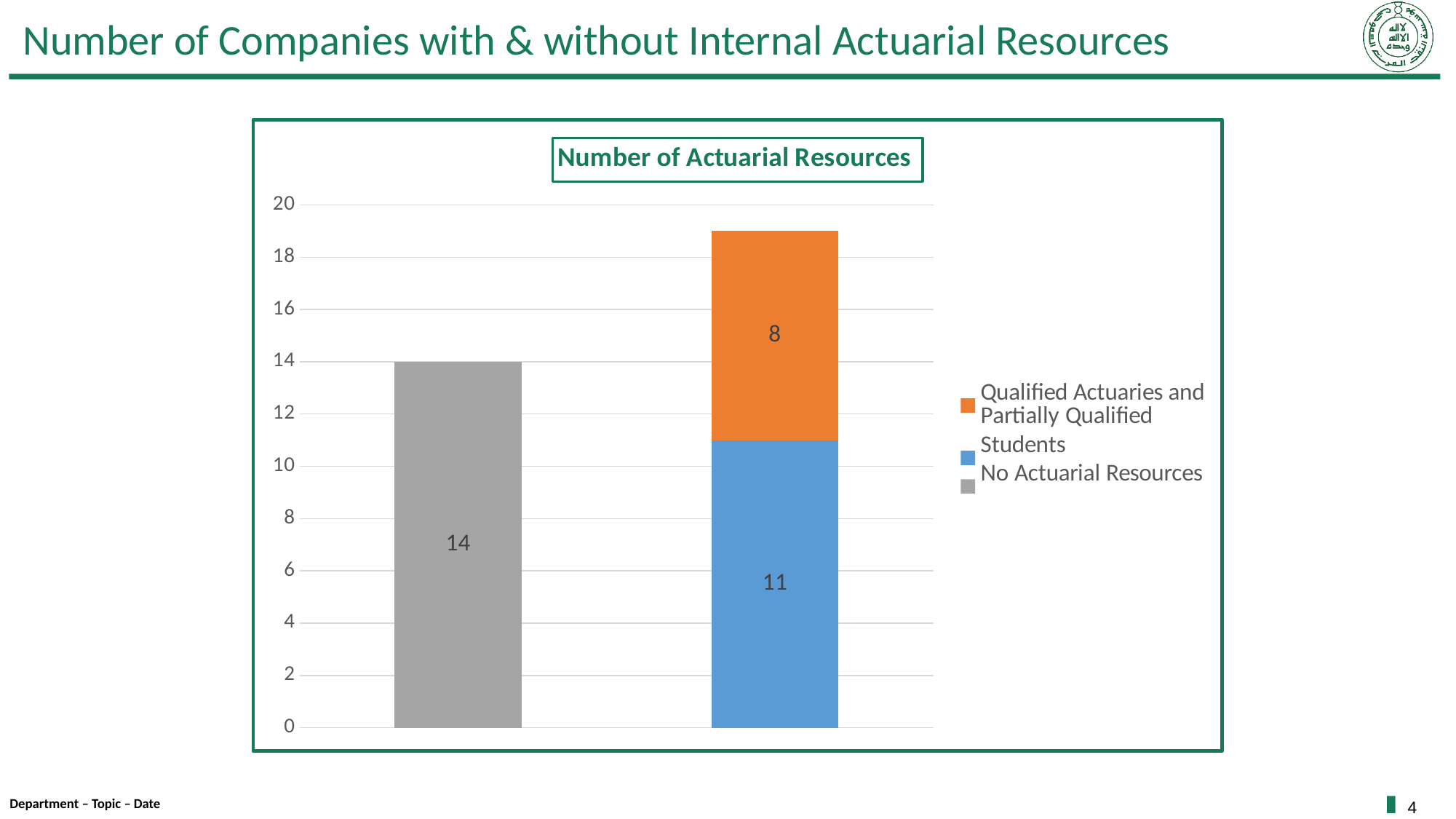
How many series does the legend list? 3 What is the value of the Qualified Actuaries and Partially Qualified segment in the right-hand stacked bar? 8 What is the difference between the Students value and the Qualified Actuaries and Partially Qualified value? 3 Which series has the smallest value in the chart? Qualified Actuaries and Partially Qualified What is the value of the No Actuarial Resources bar? 14 What is the value of the Students segment in the right-hand stacked bar? 11 What is the total of the right-hand stacked bar (Students plus Qualified Actuaries and Partially Qualified)? 19 What is the difference between the No Actuarial Resources value and the Students value? 3 Which is larger, the No Actuarial Resources value or the Students value? No Actuarial Resources What kind of chart is shown on the slide? Stacked bar chart What is the title of the chart? Number of Actuarial Resources Is the total height of the right-hand stacked bar greater or less than 18? greater